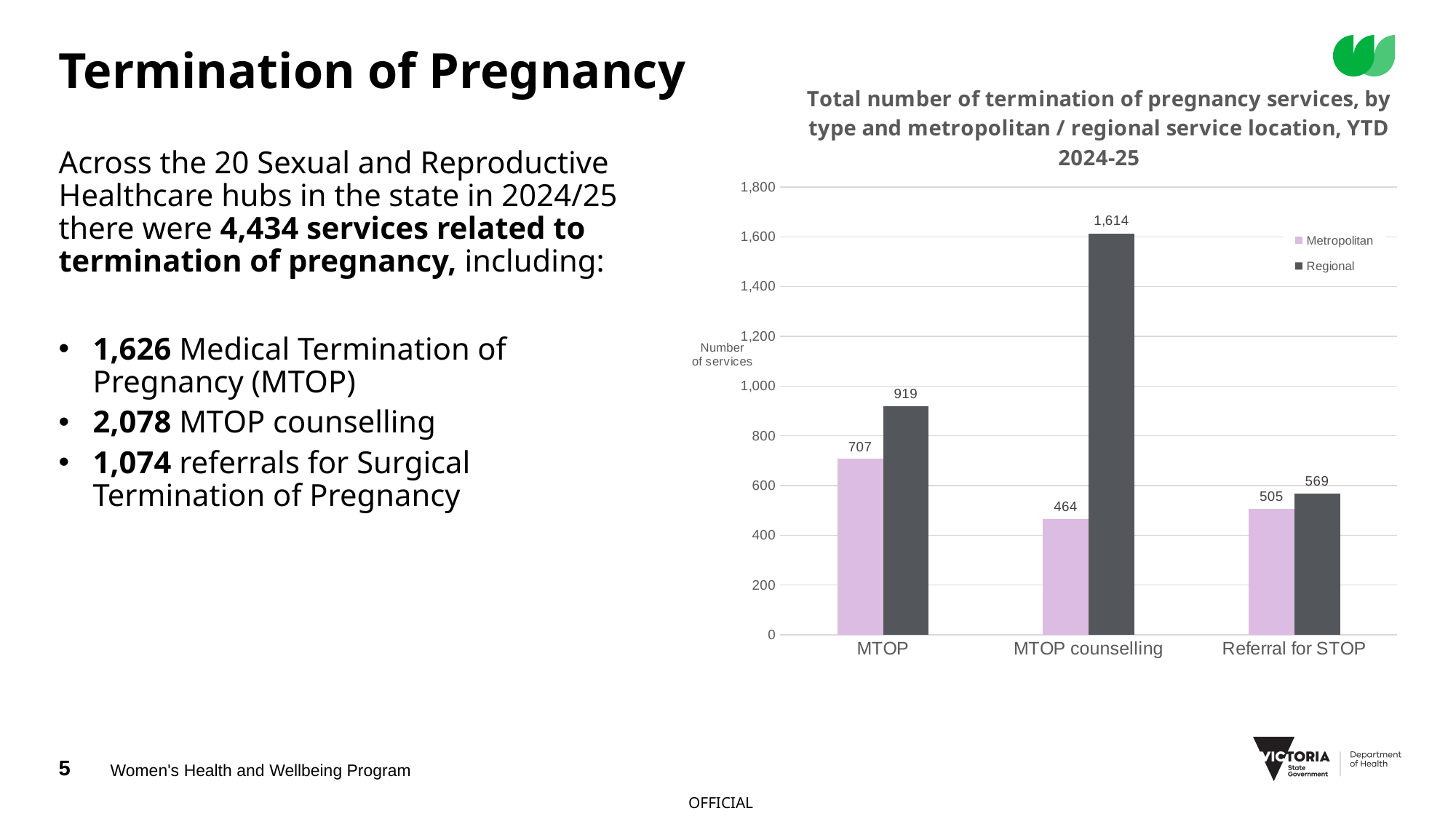
What kind of chart is shown on the slide? bar chart What is the Metropolitan value for Referral for STOP? 505 What is the Metropolitan value for MTOP? 707 Is the Regional value for Referral for STOP greater or less than 600? less What is the difference between the Regional and Metropolitan values for MTOP counselling? 1,150 How many series does the legend list? 2 What is the Regional value for MTOP counselling? 1,614 Which category has the highest Regional value? MTOP counselling Which category has the lowest Metropolitan value? MTOP counselling Which is larger for MTOP: the Metropolitan value or the Regional value? Regional How many categories are shown on the x axis? 3 What is the label on the vertical axis of the chart? Number of services